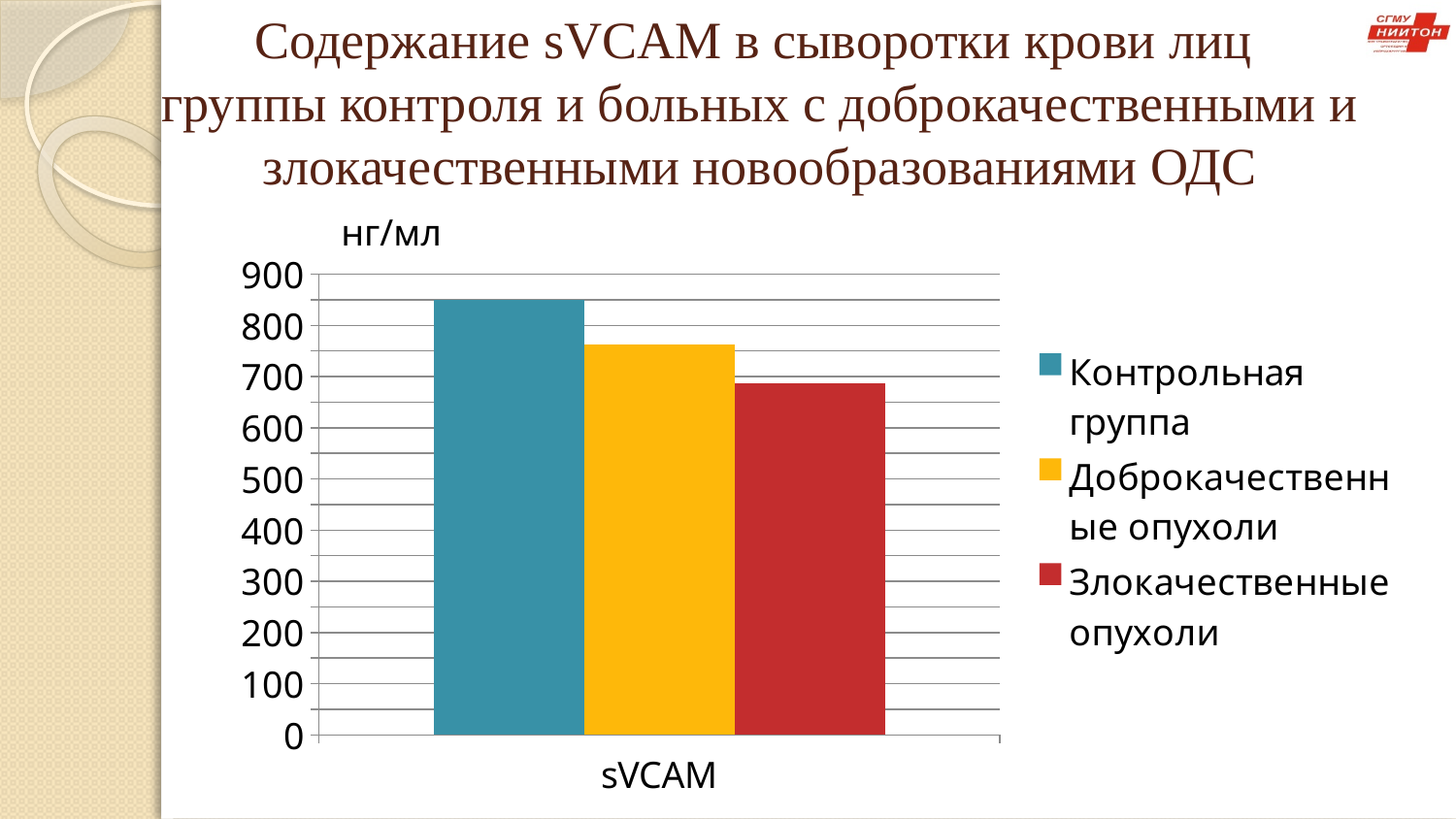
What kind of chart is shown on the slide? bar chart Is the sVCAM value for Злокачественные опухоли greater or less than 700? less Is the sVCAM value for Контрольная группа greater or less than 800? greater Is the sVCAM value for Доброкачественные опухоли greater or less than 700? greater Which is larger, the sVCAM value for Доброкачественные опухоли or for Злокачественные опухоли? Доброкачественные опухоли How many categories are shown on the x axis? 1 Which series has the highest sVCAM value? Контрольная группа What is the label of the category on the x axis? sVCAM Which series has the lowest sVCAM value? Злокачественные опухоли What unit is shown on the y axis of the chart? нг/мл How many series does the legend list? 3 Which is larger, the sVCAM value for Контрольная группа or for Доброкачественные опухоли? Контрольная группа